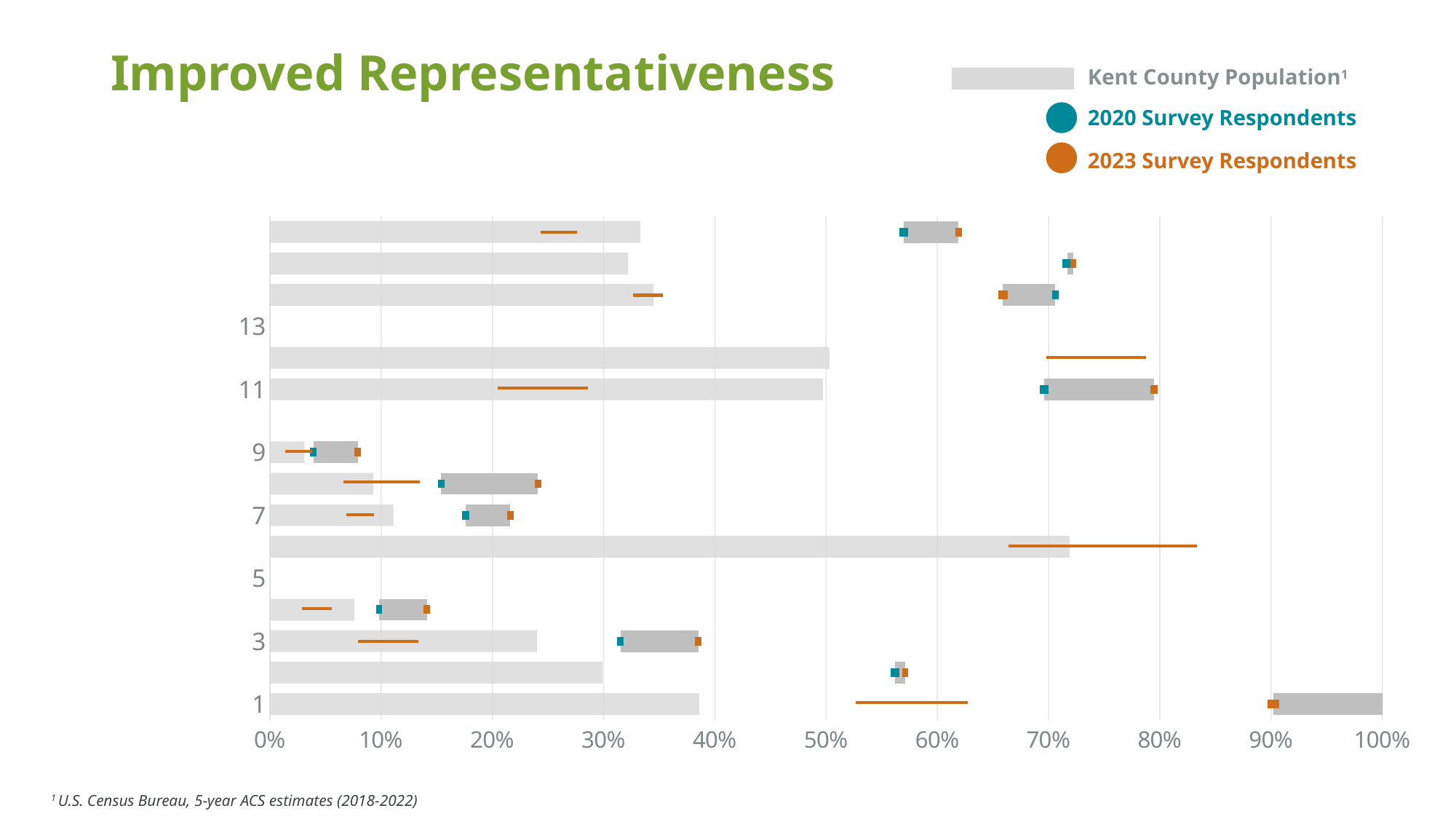
Is the Kent County Population value for category 9 greater or less than 10%? less How many series does the legend list? 3 Is the Kent County Population value for category 1 greater or less than 30%? greater Which is larger for category 1, the Kent County Population value or the 2023 Survey Respondents value? 2023 Survey Respondents Is the Kent County Population value for category 7 greater or less than 20%? less What kind of chart is shown on the slide? Bar chart Which series is shown in grey in the legend? Kent County Population What is the highest value shown on the x axis? 100% What is the title of the slide's chart? Improved Representativeness